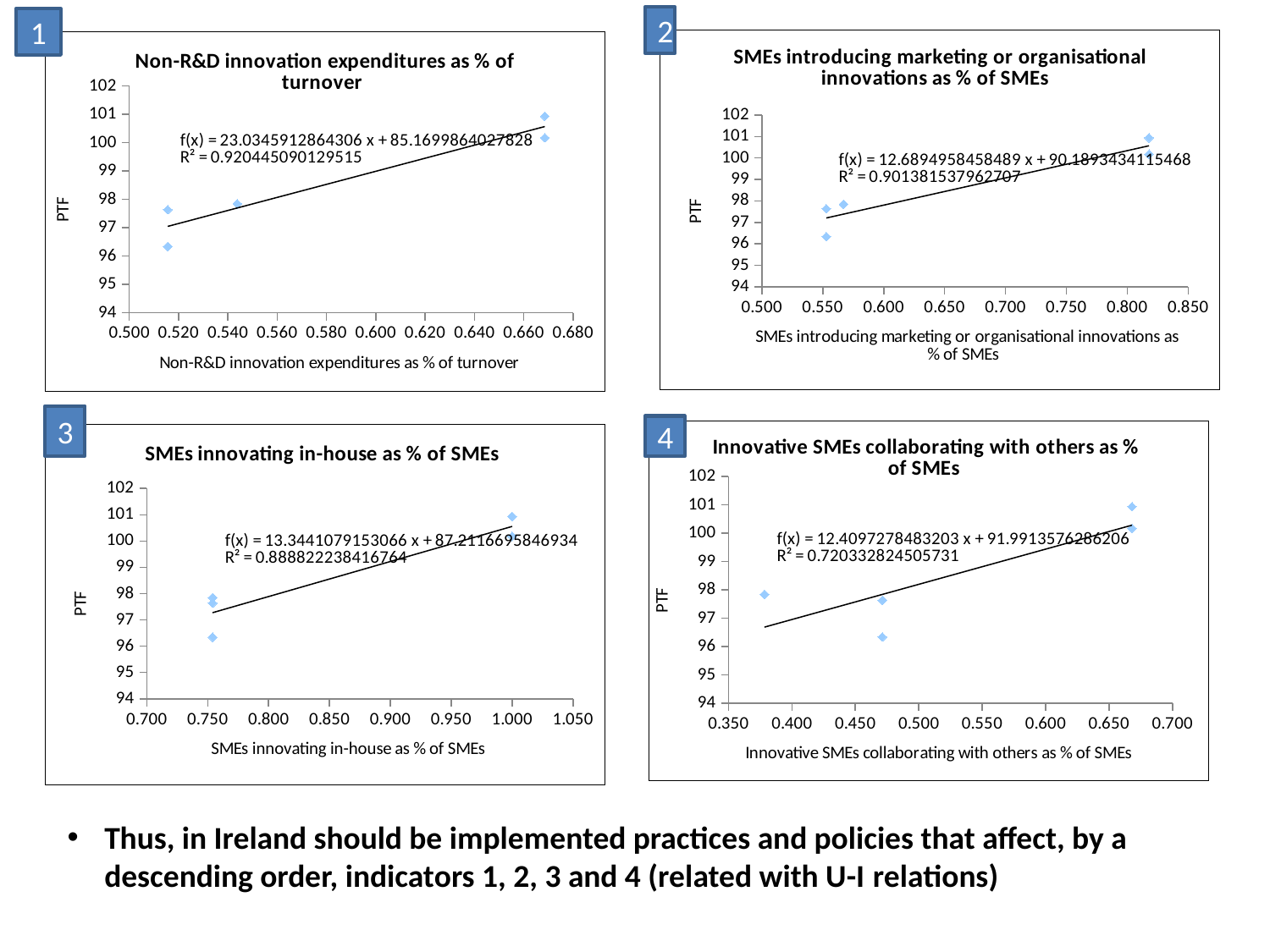
In chart 1, "Non-R&D innovation expenditures as % of turnover", what is the slope (coefficient of x) in the printed trendline equation? 23.0345912864306 Is the slope of the trendline in chart 1 larger or smaller than the slope of the trendline in chart 3? Larger In chart 4, "Innovative SMEs collaborating with others as % of SMEs", is the PTF value of the highest point greater or less than 100? greater Which of the four charts shows the lowest R² value for its trendline? Chart 4 (Innovative SMEs collaborating with others as % of SMEs) In chart 3, "SMEs innovating in-house as % of SMEs", what R² value is printed for the trendline? 0.888822238416764 What is the label on the vertical axis of chart 3, "SMEs innovating in-house as % of SMEs"? PTF In chart 1, "Non-R&D innovation expenditures as % of turnover", what R² value is printed for the trendline? 0.920445090129515 In chart 4, "Innovative SMEs collaborating with others as % of SMEs", what R² value is printed for the trendline? 0.720332824505731 Which of the four charts shows the highest R² value for its trendline? Chart 1 (Non-R&D innovation expenditures as % of turnover) In chart 2, "SMEs introducing marketing or organisational innovations as % of SMEs", what R² value is printed for the trendline? 0.901381537962707 What kind of chart is chart 1, "Non-R&D innovation expenditures as % of turnover"? Scatter chart In chart 2, "SMEs introducing marketing or organisational innovations as % of SMEs", do the PTF values generally rise or fall as the x-axis value increases? Rise